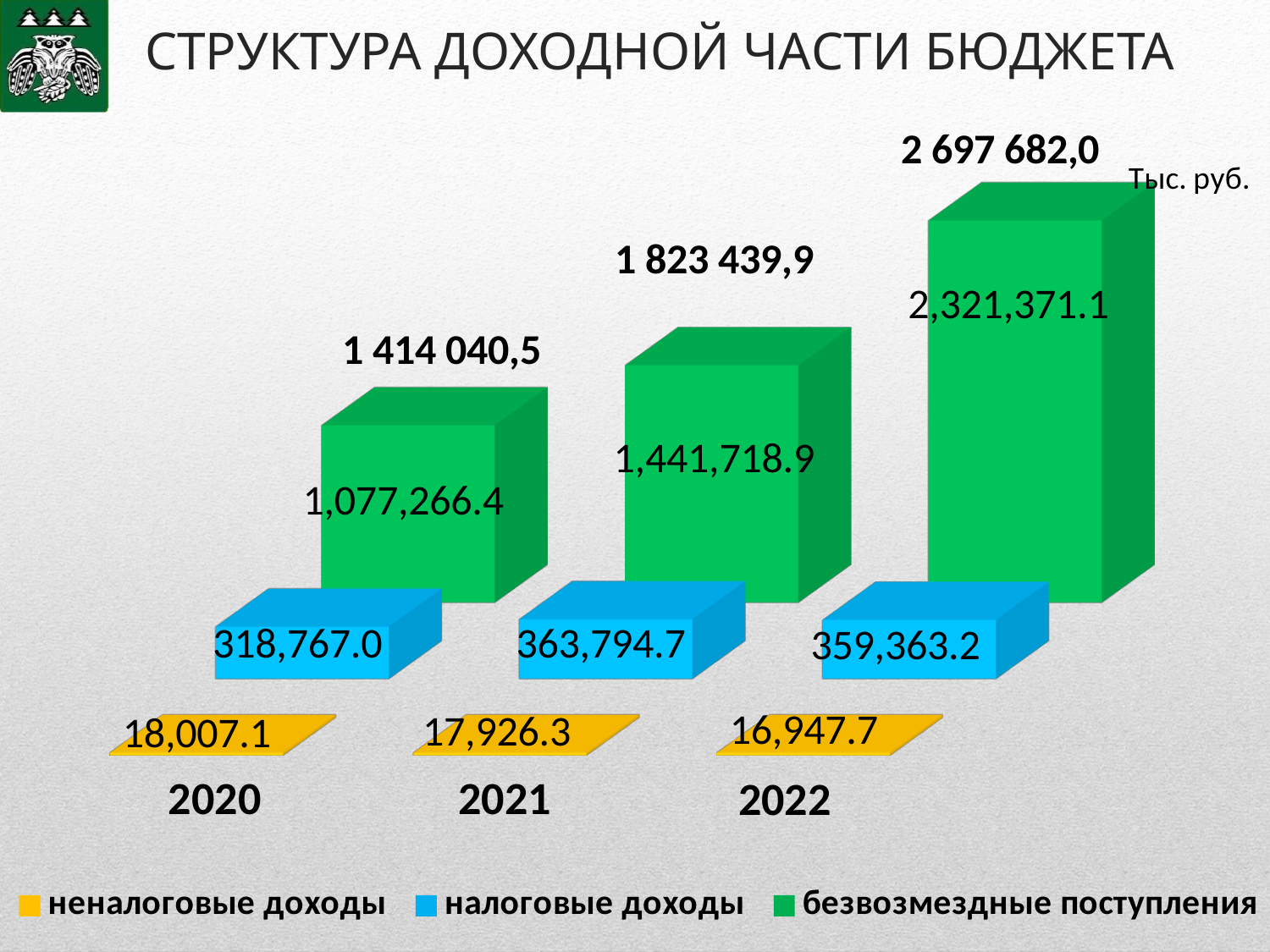
How many years are shown on the x axis? 3 Which is larger: налоговые доходы in 2021 or in 2022? 2021 What kind of chart is shown on the slide? 3D bar chart Which year has the highest value of безвозмездные поступления? 2022 What is the difference between безвозмездные поступления in 2021 and in 2020? 364,452.5 What is the value of налоговые доходы for 2021? 363,794.7 What is the value of безвозмездные поступления for 2022? 2,321,371.1 What is the value of неналоговые доходы for 2020? 18,007.1 Do the stacked bar totals rise or fall from 2020 to 2022? Rise Which year has the lowest value of неналоговые доходы? 2022 How many series does the legend list? 3 What is the total printed above the stacked bar for 2021? 1 823 439,9